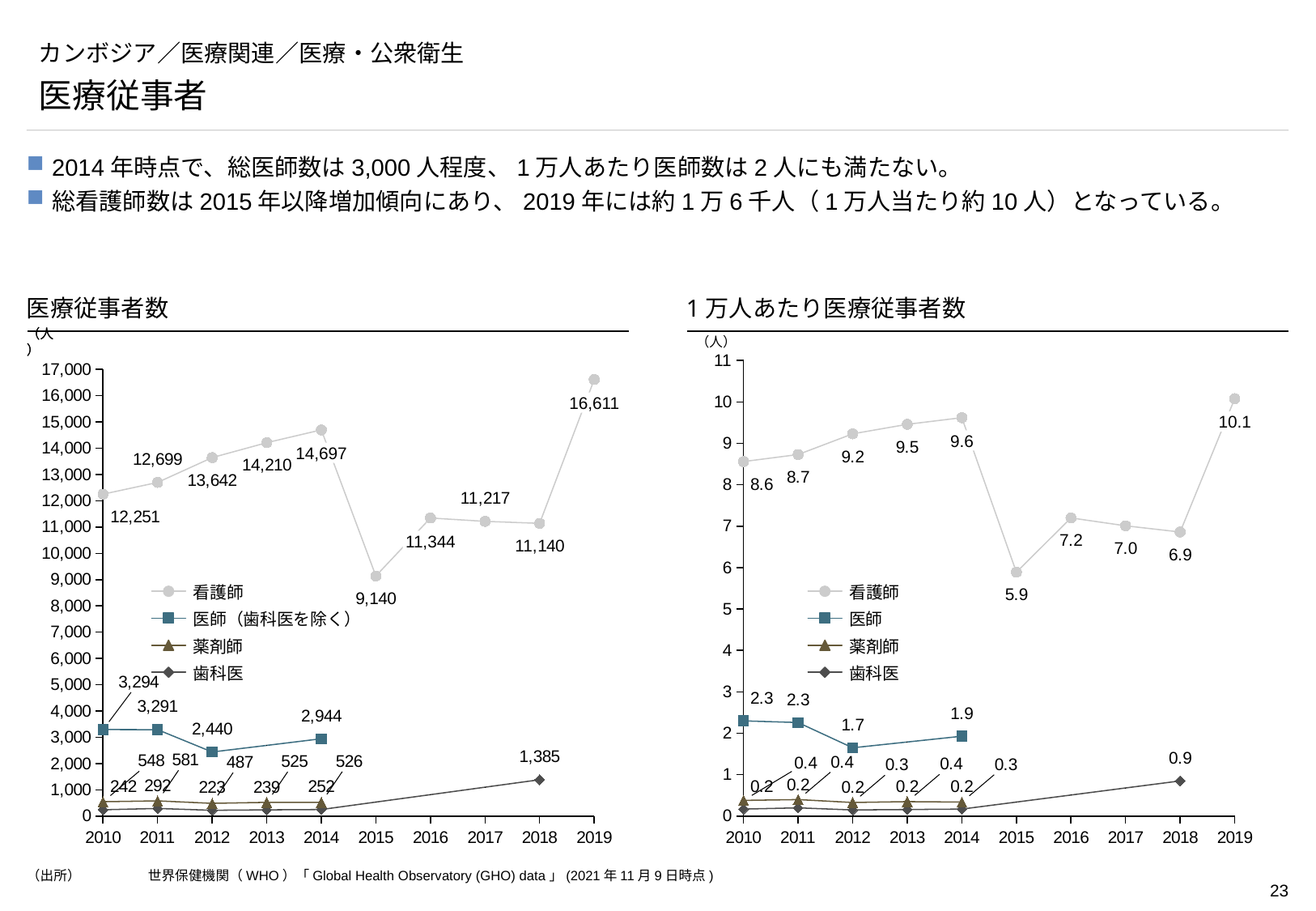
In the 医療従事者数 chart on the left, what is the value for 看護師 in 2019? 16,611 In the 1万人あたり医療従事者数 chart on the right, what is the value for 看護師 in 2019? 10.1 In the 医療従事者数 chart on the left, what is the difference between the 看護師 values for 2014 and 2015? 5,557 In the 1万人あたり医療従事者数 chart on the right, what is the value for 医師 in 2012? 1.7 In the 1万人あたり医療従事者数 chart on the right, which year has the lowest value for 看護師? 2015 In the 医療従事者数 chart on the left, what is the value for 看護師 in 2015? 9,140 In the 1万人あたり医療従事者数 chart on the right, is the 看護師 value for 2014 larger or smaller than the value for 2018? larger In the 医療従事者数 chart on the left, what is the value for 歯科医 in 2018? 1,385 In the 医療従事者数 chart on the left, how many series does the legend list? 4 In the 医療従事者数 chart on the left, what is the value for 医師（歯科医を除く） in 2014? 2,944 In the 医療従事者数 chart on the left, which year has the highest value for 看護師? 2019 What kind of chart is the 1万人あたり医療従事者数 chart on the right? line chart